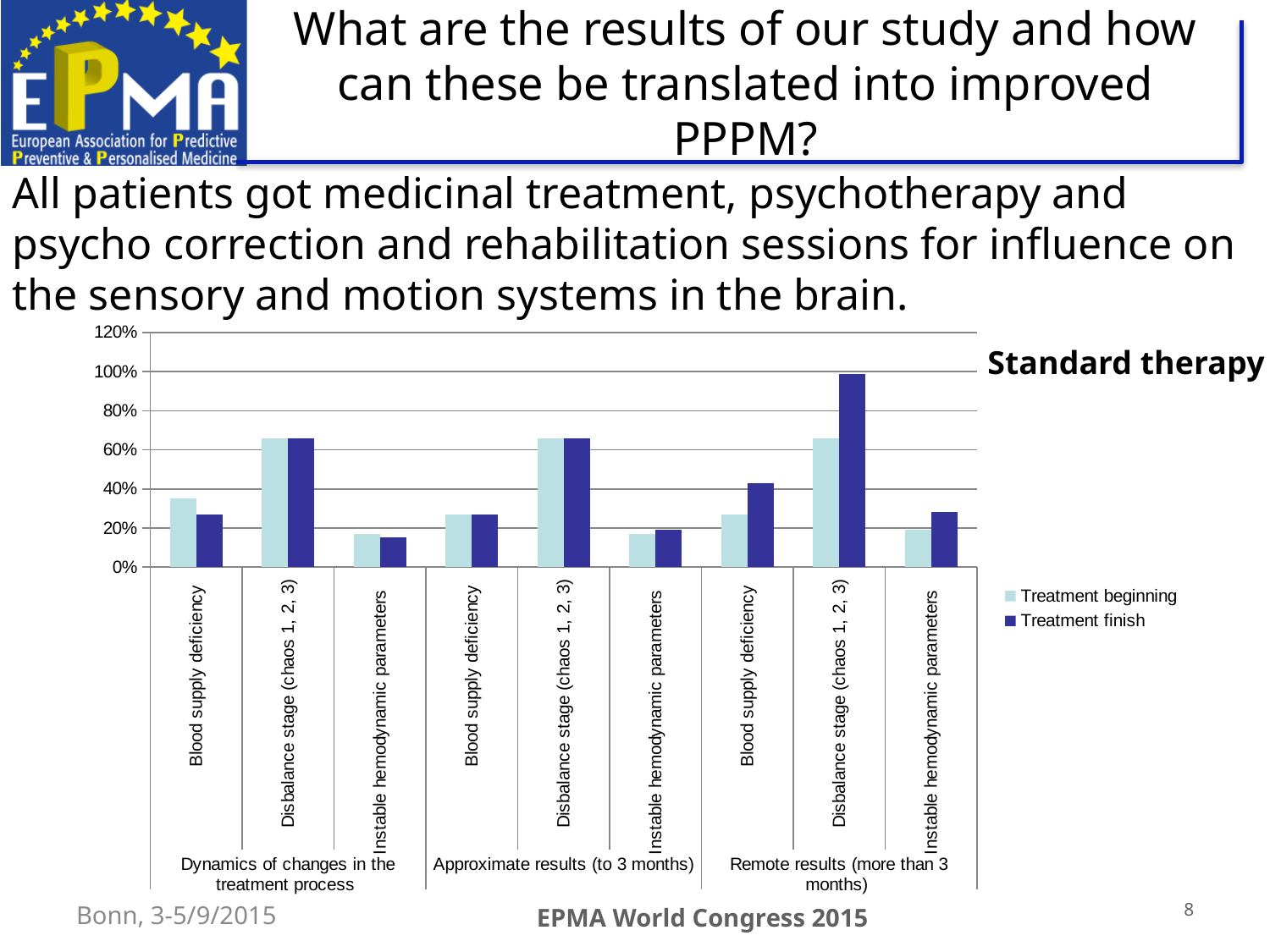
Is the Treatment beginning value for Instable hemodynamic parameters under Dynamics of changes in the treatment process greater or less than 20%? less For Disbalance stage (chaos 1, 2, 3) under Remote results (more than 3 months), which is larger: Treatment beginning or Treatment finish? Treatment finish What are the two series named in the chart legend? Treatment beginning and Treatment finish What label appears in bold to the right of the chart, above the legend? Standard therapy For Blood supply deficiency under Dynamics of changes in the treatment process, which is larger: Treatment beginning or Treatment finish? Treatment beginning How many series does the chart legend list? 2 Is the Treatment beginning value for Blood supply deficiency under Dynamics of changes in the treatment process greater or less than 40%? less What kind of chart is shown on the slide? bar chart Is the Treatment finish value for Disbalance stage (chaos 1, 2, 3) under Remote results (more than 3 months) greater or less than 80%? greater How many category bars groups (x-axis categories) are plotted in the chart? 9 Which bar in the chart is the highest overall? Treatment finish for Disbalance stage (chaos 1, 2, 3) under Remote results (more than 3 months)